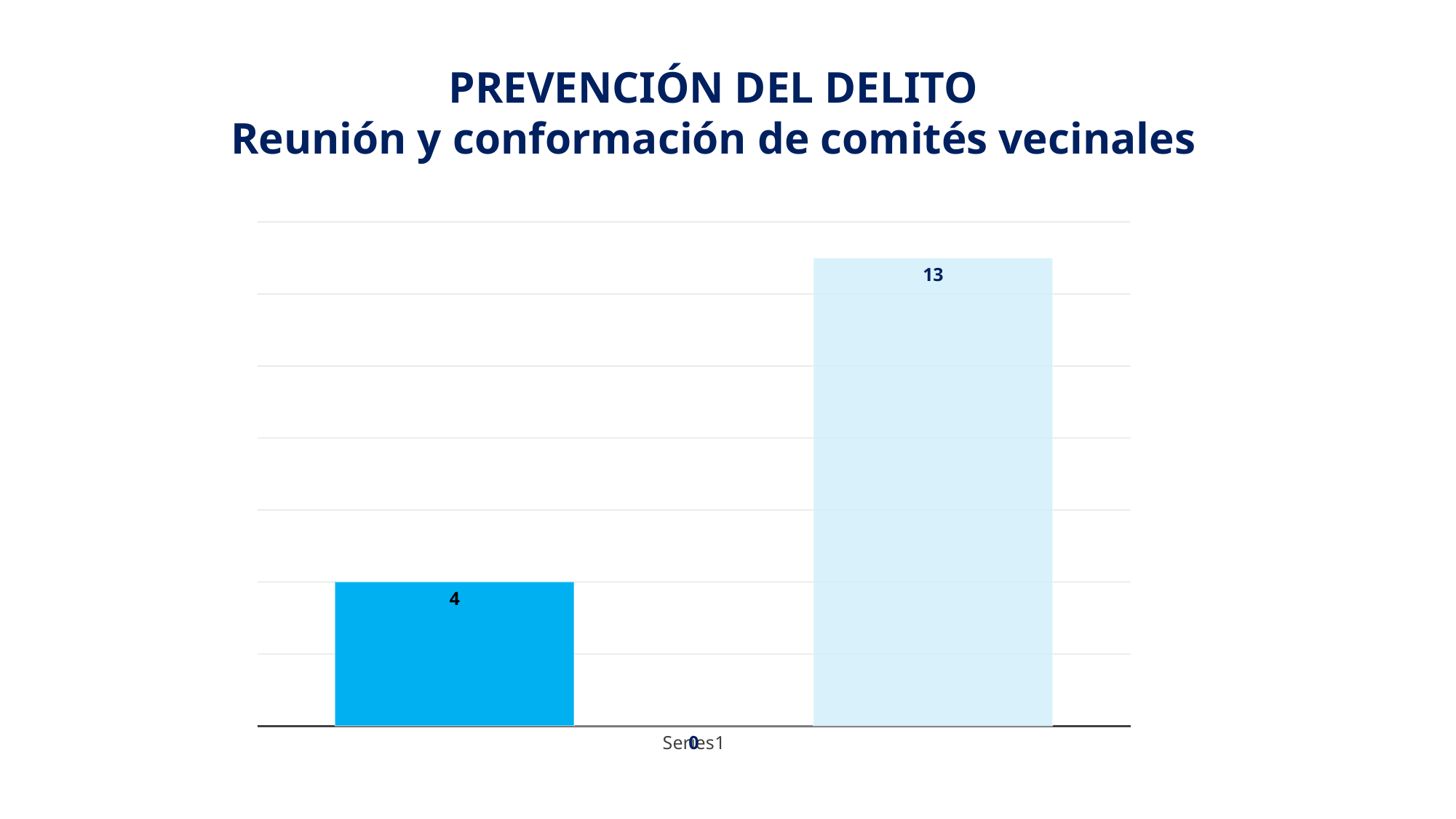
What is the difference between the value of the right-hand bar (13) and the left-hand bar (4)? 9 What is the total of the three values labelled in the chart? 17 What is the value shown on the bright blue bar on the left of the chart? 4 What is the value shown on the tallest bar in the chart? 13 What is the value of the middle bar, labelled at the base of the chart? 0 Which bar is larger, the bright blue bar on the left or the light blue bar on the right? the light blue bar on the right What category label appears on the horizontal axis of the chart? Series1 How many data labels are printed in the chart? 3 What is the first line of the chart's title? PREVENCIÓN DEL DELITO What kind of chart is shown on the slide? bar chart What is the lowest value labelled in the chart? 0 What is the value shown on the light blue bar on the right of the chart? 13